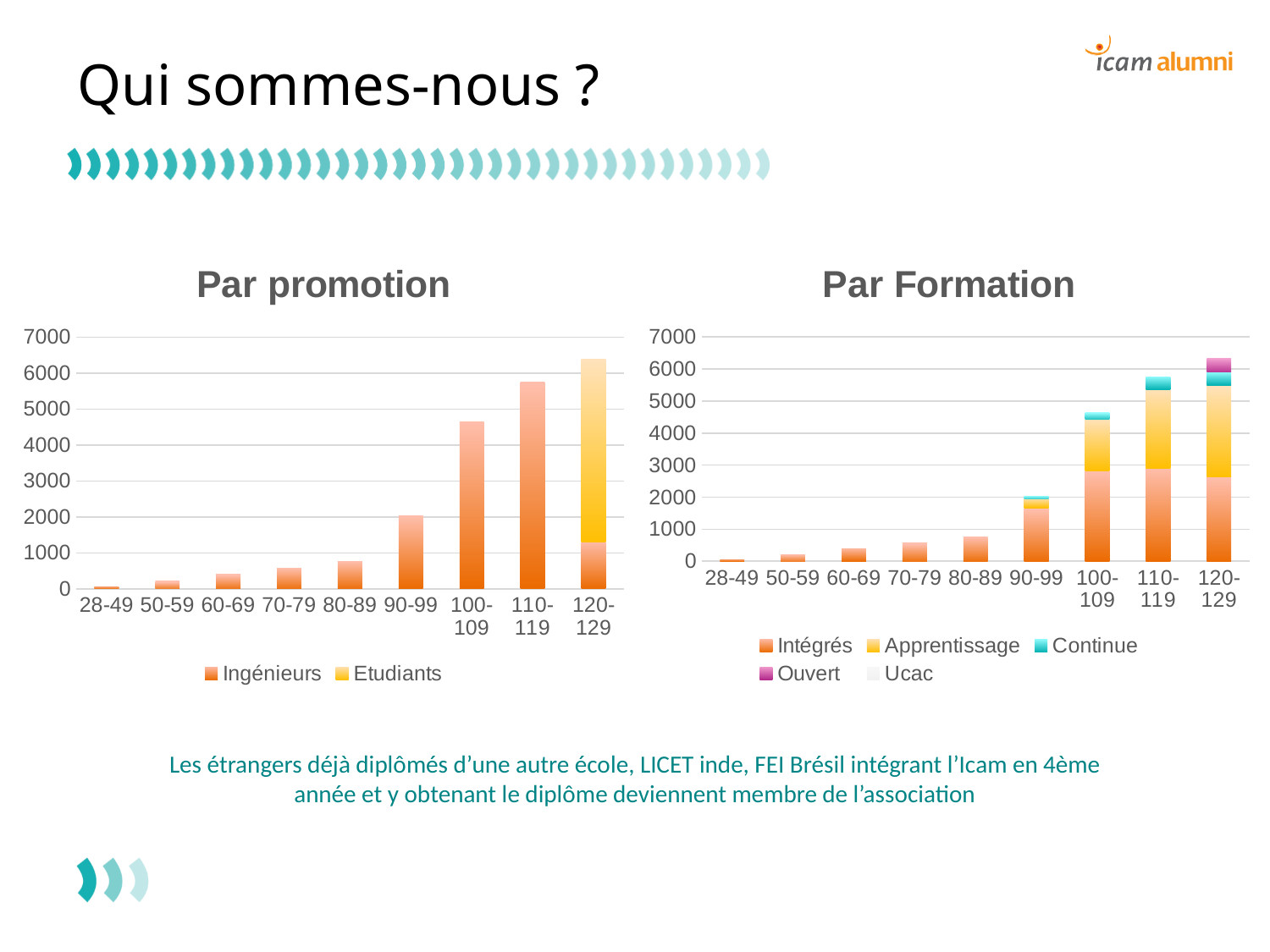
In the 'Par promotion' chart, is the total for 110-119 greater or less than 5000? greater How many series does the legend of the 'Par promotion' chart list? 2 In the 'Par promotion' chart, which promotion category has the shortest bar? 28-49 In the 'Par promotion' chart, which bar is taller: 100-109 or 110-119? 110-119 In the 'Par Formation' chart, do the bar totals generally rise or fall from left to right along the x axis? rise In the 'Par promotion' chart, which promotion category has the tallest bar? 120-129 In the 'Par Formation' chart, is the total for 100-109 greater or less than 4000? greater How many series does the legend of the 'Par Formation' chart list? 5 In the 'Par Formation' chart, which promotion category has the tallest stacked bar? 120-129 In the 'Par promotion' chart, is the total for 80-89 greater or less than 1000? less How many promotion categories are shown on the x axis of the 'Par promotion' chart? 9 What kind of chart is the 'Par promotion' chart? bar chart